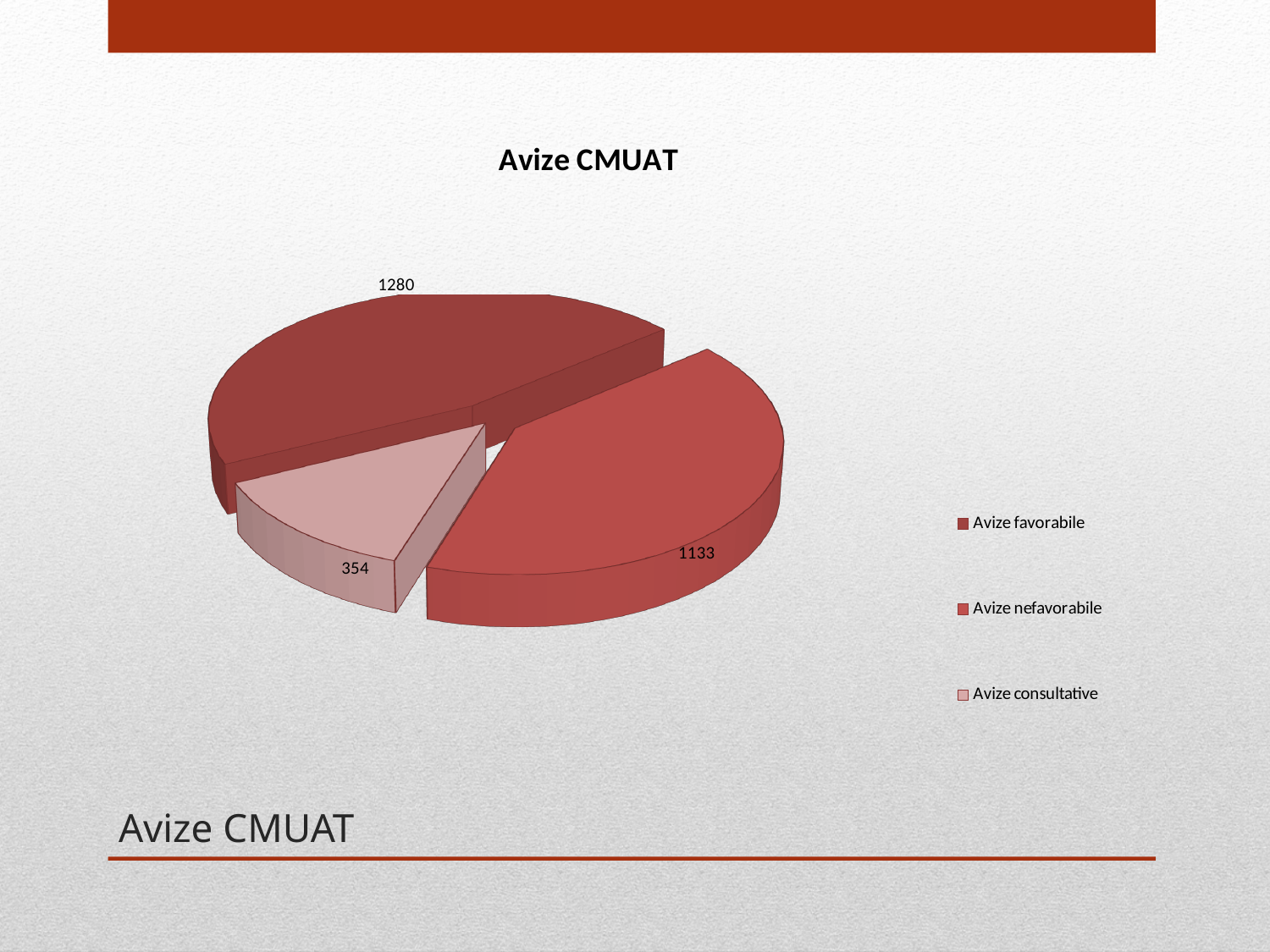
What type of chart is shown on the slide? pie chart What is the difference between Avize favorabile and Avize nefavorabile? 147 How many slices does the pie chart have? 3 Which category has the largest slice? Avize favorabile Which is larger, Avize nefavorabile or Avize consultative? Avize nefavorabile What is the value for Avize favorabile? 1280 How many entries does the legend list? 3 What is the value for Avize consultative? 354 What is the value for Avize nefavorabile? 1133 What is the title of the chart? Avize CMUAT What is the total of all three slices? 2767 Which category has the smallest slice? Avize consultative